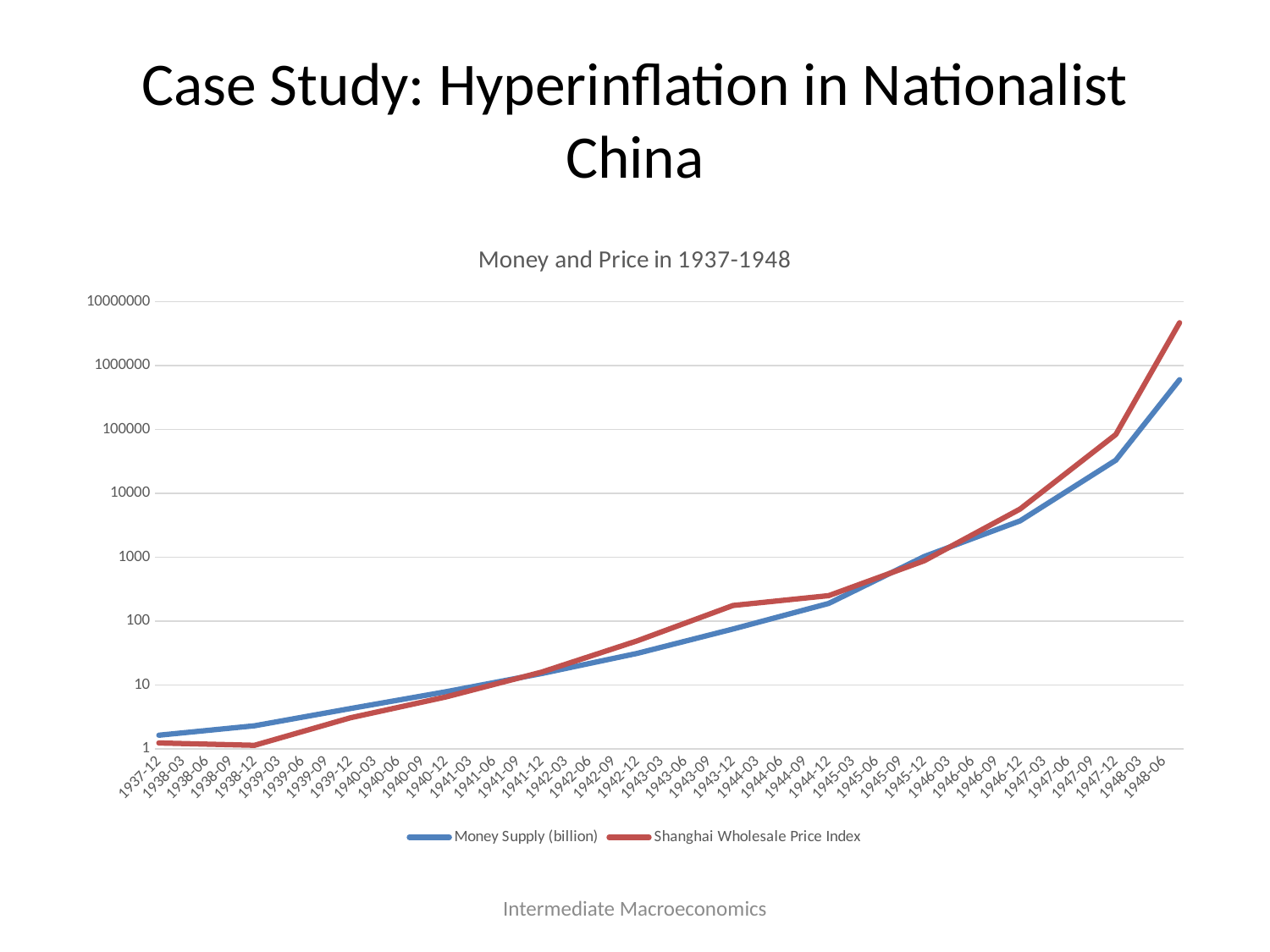
Which series is drawn in red? Shanghai Wholesale Price Index At 1938-12, which series has the higher value, Money Supply (billion) or Shanghai Wholesale Price Index? Money Supply (billion) At 1948-06, which series has the higher value, Money Supply (billion) or Shanghai Wholesale Price Index? Shanghai Wholesale Price Index Is the Money Supply (billion) at 1943-12 greater or less than 100? less How many series does the legend list? 2 How many time points are labelled on the x axis? 43 Is the Shanghai Wholesale Price Index at 1943-12 greater or less than 100? greater Do the values of the Money Supply (billion) series rise or fall from 1937-12 to 1948-06? rise What kind of chart is shown on the slide? line chart What is the title of the chart? Money and Price in 1937-1948 Is the Shanghai Wholesale Price Index at 1948-06 greater or less than 1000000? greater